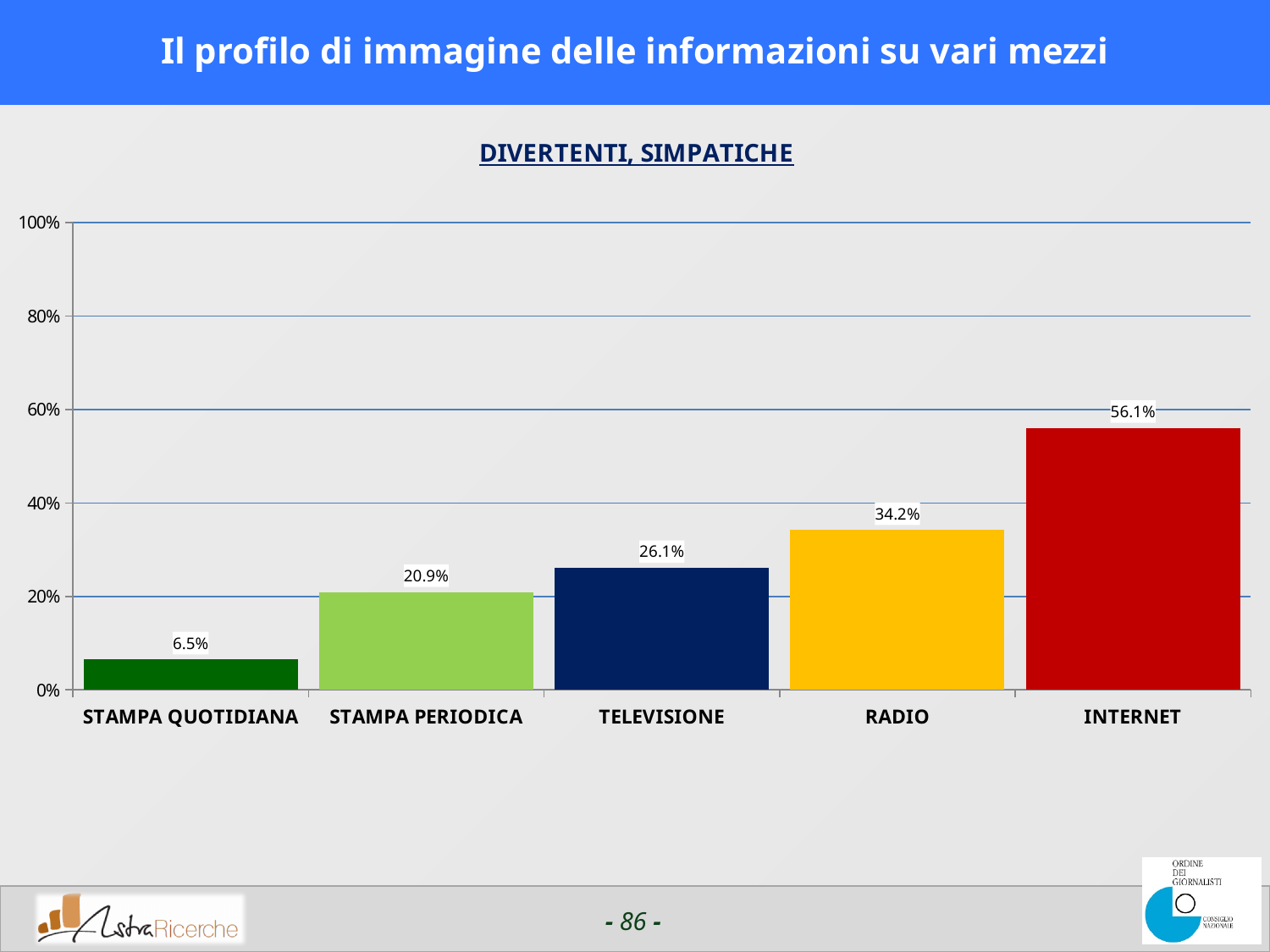
Is the value for RADIO greater or less than 40%? less Do the values rise or fall from left to right along the x axis? rise Which category has the highest value? INTERNET What is the value for RADIO? 34.2% What kind of chart is shown on the slide? bar chart Which category has the lowest value? STAMPA QUOTIDIANA What is the value for TELEVISIONE? 26.1% What is the difference between the values for INTERNET and RADIO? 21.9% What is the value for INTERNET? 56.1% What is the value for STAMPA QUOTIDIANA? 6.5% How many categories are shown on the x axis? 5 Which is larger, the value for STAMPA PERIODICA or the value for TELEVISIONE? TELEVISIONE